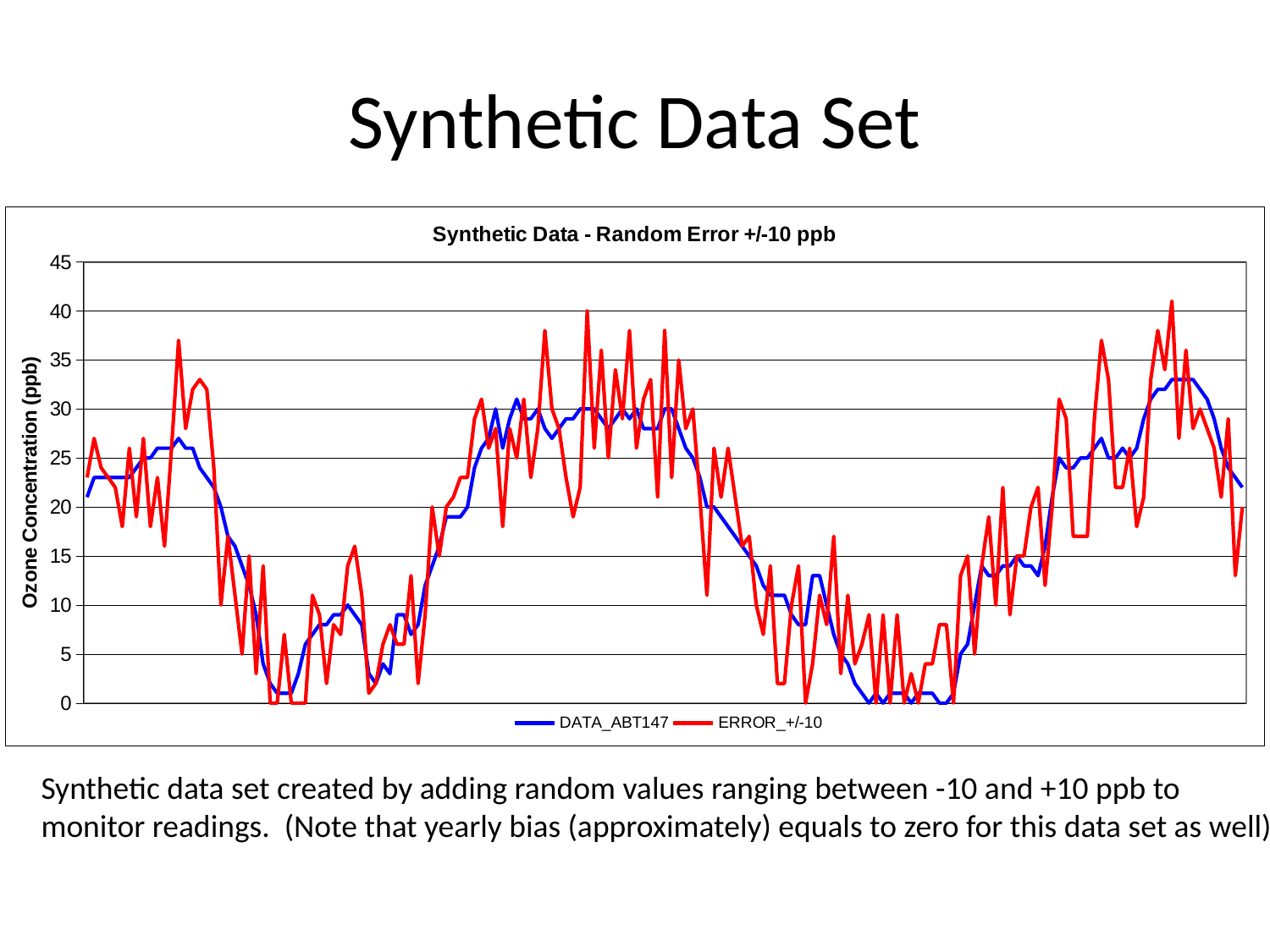
Is the highest value reached by the DATA_ABT147 series greater or less than 35? less How many series does the legend list? 2 Which series shows more point-to-point fluctuation, DATA_ABT147 or ERROR_+/-10? ERROR_+/-10 Which series reaches the higher peak value, DATA_ABT147 or ERROR_+/-10? ERROR_+/-10 What is the title of the chart? Synthetic Data - Random Error +/-10 ppb Is the highest value reached by the ERROR_+/-10 series greater or less than 35? greater What colour is the DATA_ABT147 series drawn in? blue What kind of chart is shown on the slide? line chart Is the lowest value reached by the DATA_ABT147 series greater or less than 5? less